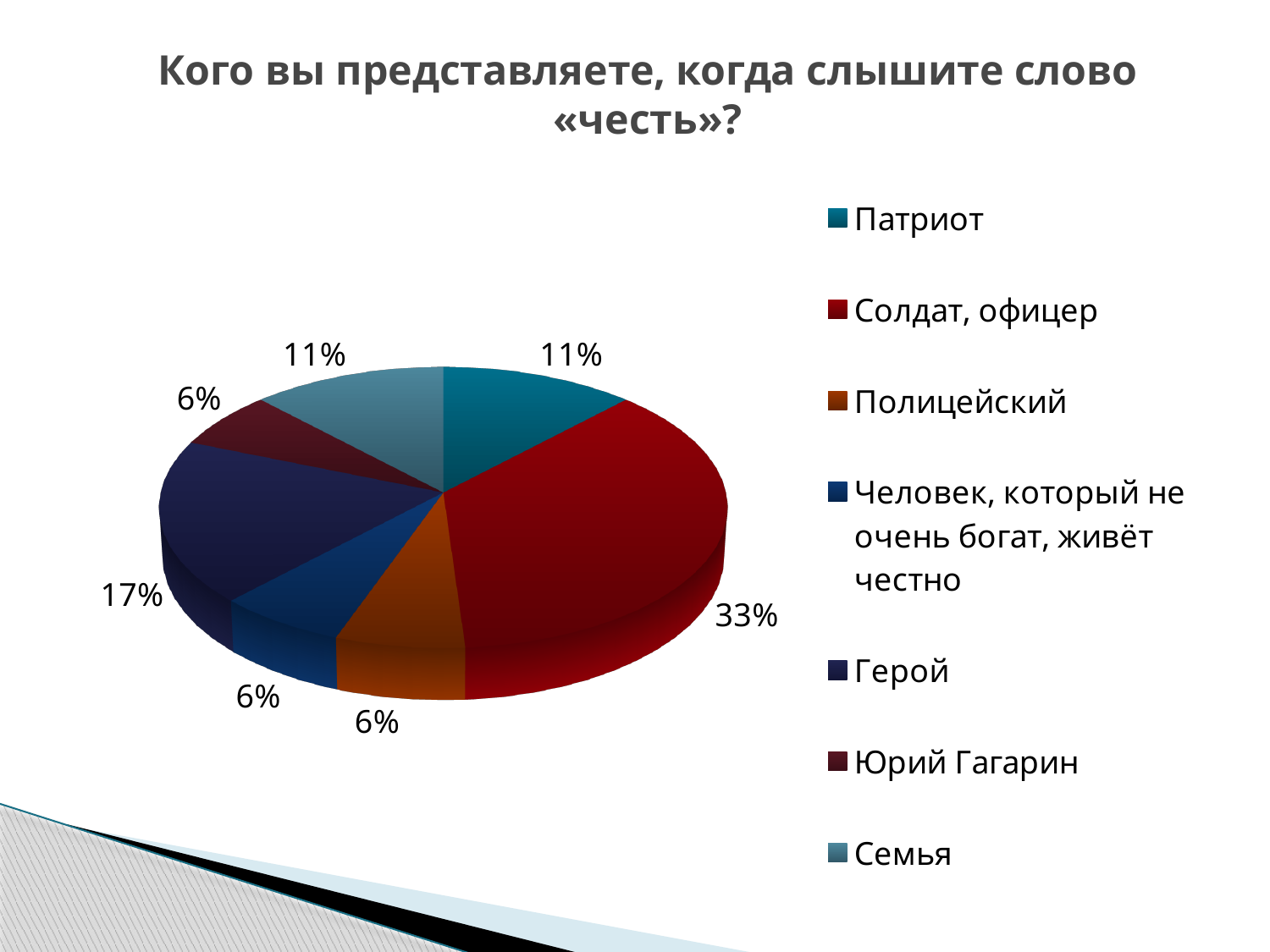
Which is larger, the share for «Герой» or the share for «Патриот»? Герой What share of the pie does «Юрий Гагарин» have? 6% Which category has the largest slice of the pie? Солдат, офицер What is the difference between the shares for «Солдат, офицер» and «Герой»? 16% What share of the pie does «Семья» have? 11% What share of the pie does «Герой» have? 17% How many categories have a share of 6%? 3 What is the title of the chart? Кого вы представляете, когда слышите слово «честь»? What share of the pie does «Солдат, офицер» have? 33% How many categories does the legend list? 7 What kind of chart is shown on the slide? pie chart What share of the pie does «Патриот» have? 11%